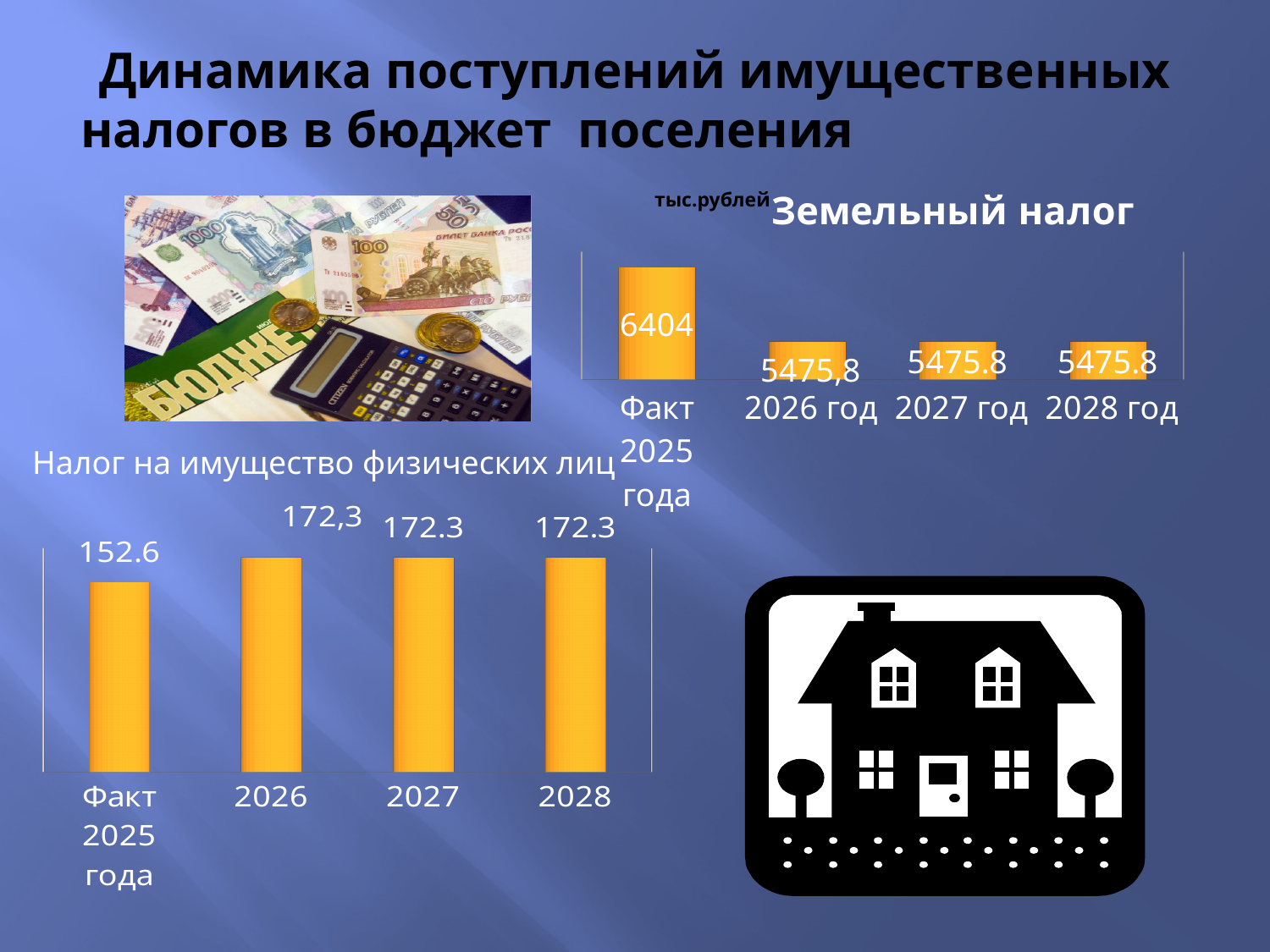
On the 'Земельный налог' chart, which category has the highest value? Факт 2025 года On the 'Земельный налог' chart, what is the value for 'Факт 2025 года'? 6404 On the 'Налог на имущество физических лиц' chart, what is the difference between the value for 2027 and the value for 'Факт 2025 года'? 19.7 On the 'Налог на имущество физических лиц' chart, what is the value for 2028? 172.3 On the 'Налог на имущество физических лиц' chart, how many categories are shown on the x axis? 4 What type of chart is the 'Налог на имущество физических лиц' chart? bar chart On the 'Земельный налог' chart, what is the value for '2027 год'? 5475.8 On the 'Земельный налог' chart, is the value for 'Факт 2025 года' larger or smaller than the value for '2026 год'? larger On the 'Земельный налог' chart, what is the unit shown above the chart? тыс.рублей On the 'Земельный налог' chart, how many bars are plotted? 4 On the 'Налог на имущество физических лиц' chart, what is the value for 'Факт 2025 года'? 152.6 On the 'Налог на имущество физических лиц' chart, which category has the lowest value? Факт 2025 года